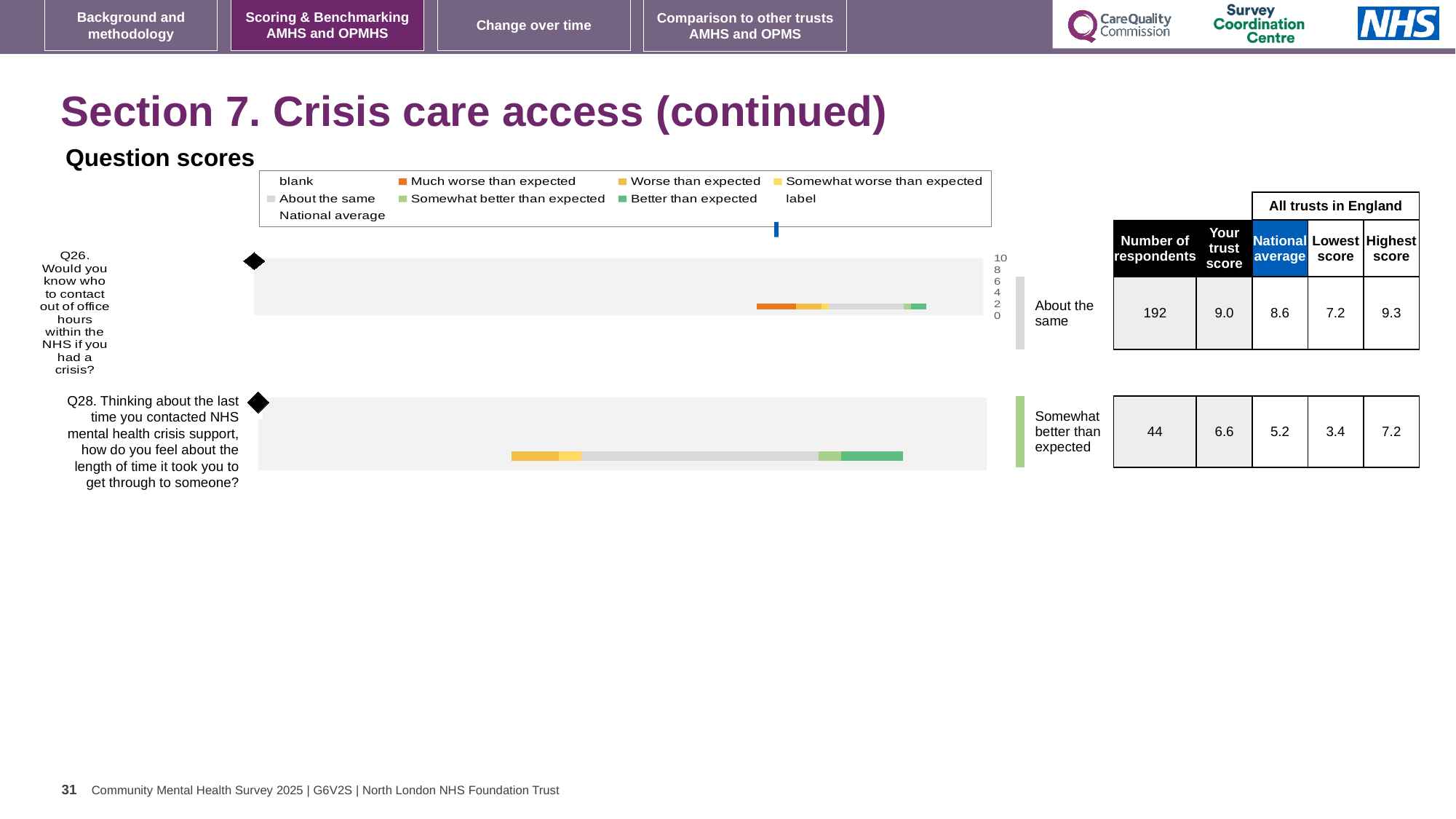
What is the highest score among all trusts in England for Q26? 9.3 How many questions are plotted in the question scores chart? 2 What benchmark category label is shown next to the Q28 bar? Somewhat better than expected What kind of chart is used to show the question scores on this slide? bar chart What is the lowest score among all trusts in England for Q28? 3.4 What is the difference between the trust score and the national average for Q26? 0.4 What is the difference between the trust score and the national average for Q28? 1.4 What benchmark category label is shown next to the Q26 bar? About the same What is the trust's score for Q26 (knowing who to contact out of office hours in a crisis)? 9.0 What is the national average score for Q28 (length of time to get through to crisis support)? 5.2 What is the number of respondents for Q26 in the table beside the chart? 192 Which question has the higher trust score, Q26 or Q28? Q26